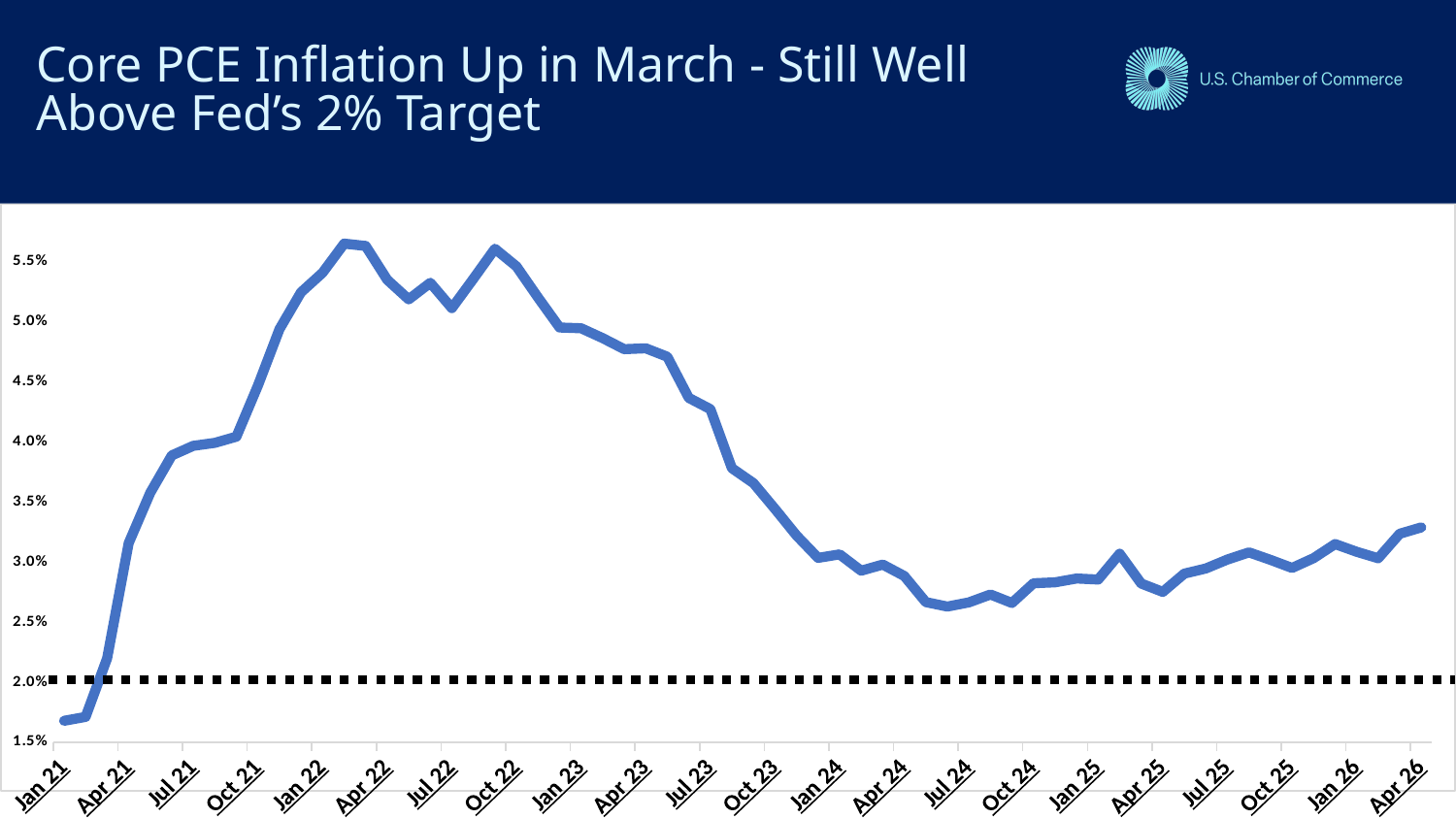
Is the value for Jul 24 greater or less than 3.0%? less How many labels are shown on the x axis? 22 Is the value for Apr 26 greater or less than 3.0%? greater What kind of chart is shown on the slide? line chart Is the value for Oct 23 greater or less than 4.0%? less Between Apr 22 and Jul 24, does the line generally rise or fall? fall What level does the dotted horizontal line on the chart mark? 2.0% What is the title of the chart on the slide? Core PCE Inflation Up in March - Still Well Above Fed's 2% Target At which x-axis label is the plotted value lowest? Jan 21